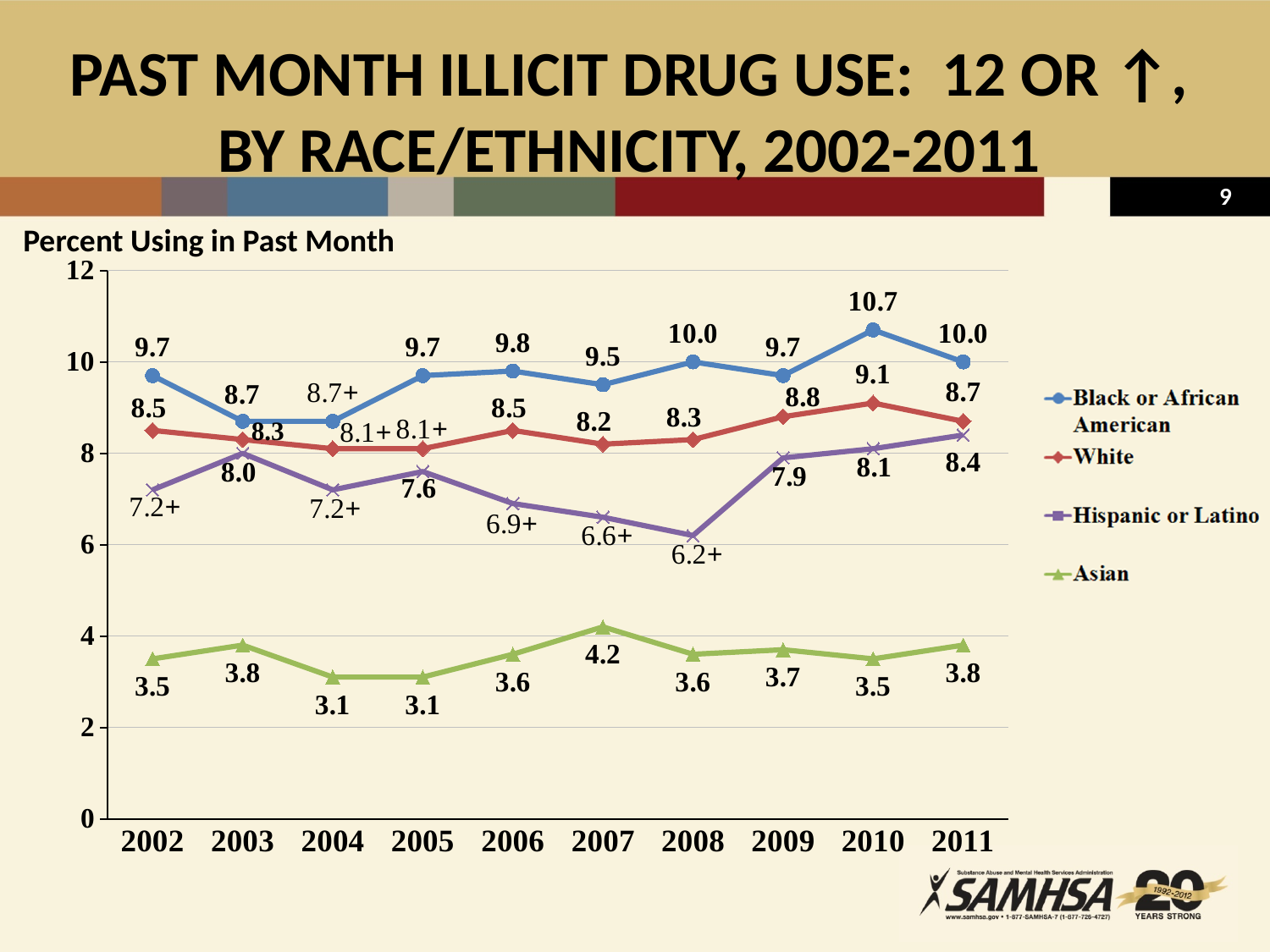
What is the value for Black or African American in 2010? 10.7 What is the difference between the Black or African American and White values in 2011? 1.3 How many series does the legend list? 4 Does the Hispanic or Latino value rise or fall from 2005 to 2008? Fall What is the value for Asian in 2007? 4.2 What kind of chart is shown on the slide? Line chart Which is larger in 2003: the White value or the Hispanic or Latino value? White How many years are shown on the x axis? 10 What is the value for Hispanic or Latino in 2011? 8.4 What is the value for White in 2009? 8.8 In which year is the Asian value lowest? 2004 and 2005 In which year is the Black or African American value highest? 2010